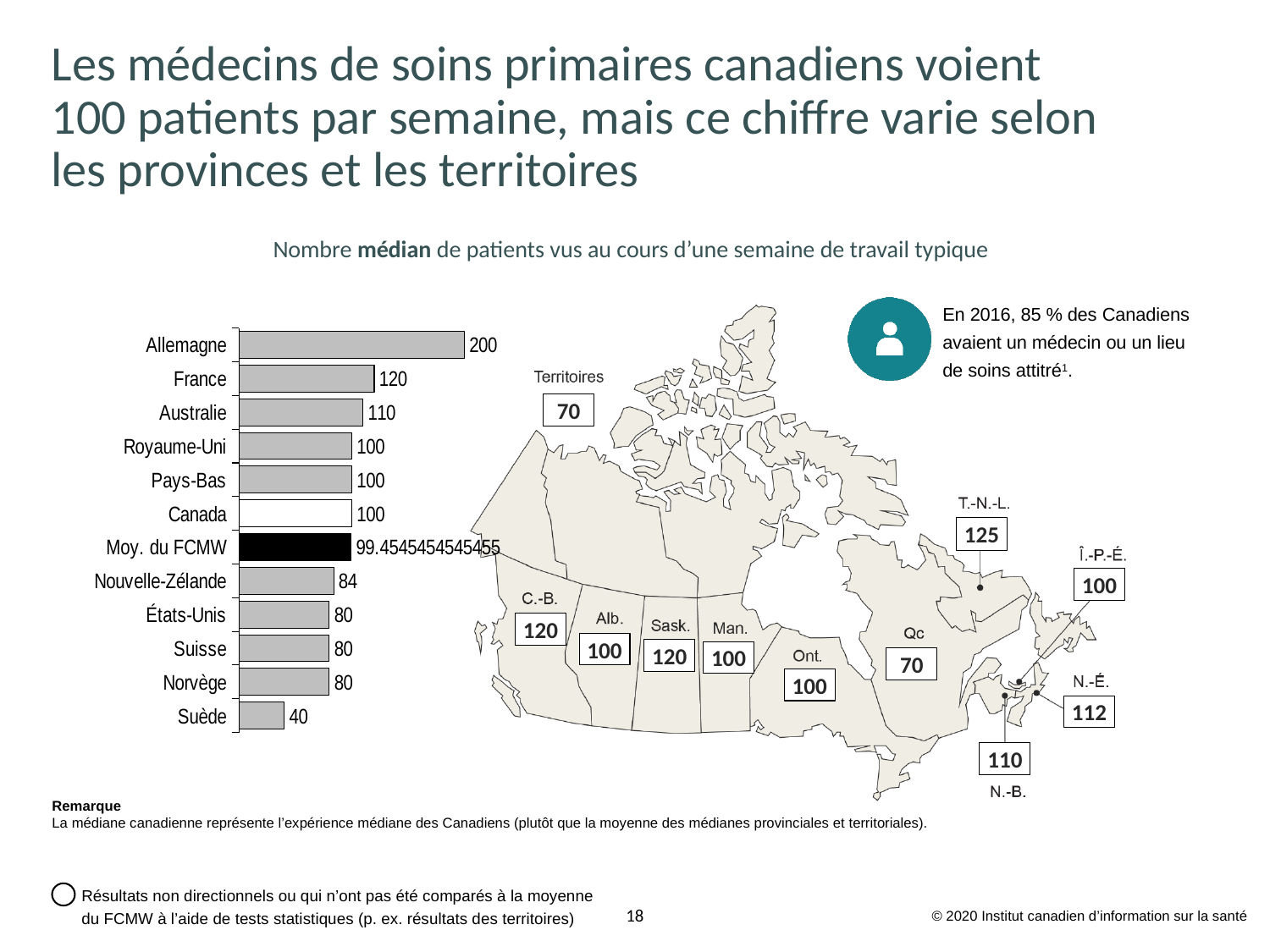
What type of chart is used to show the median number of patients by country? Bar chart In the bar chart, what is the median number of patients seen per week for Allemagne? 200 In the bar chart, what value is shown for Moy. du FCMW? 99.4545454545455 On the map of Canada, what is the median number of patients seen per week in T.-N.-L.? 125 In the bar chart, which country has the lowest median number of patients seen per week? Suède In the bar chart, what is the difference between the values for Allemagne and France? 80 On the map of Canada, what is the difference between the values for C.-B. and Qc? 50 In the bar chart, which country has the highest median number of patients seen per week? Allemagne In the bar chart, which is larger, the value for Australie or the value for Nouvelle-Zélande? Australie How many categories are shown in the bar chart? 12 In the bar chart, which bar is filled in black? Moy. du FCMW In the bar chart, what value is shown for Suède? 40